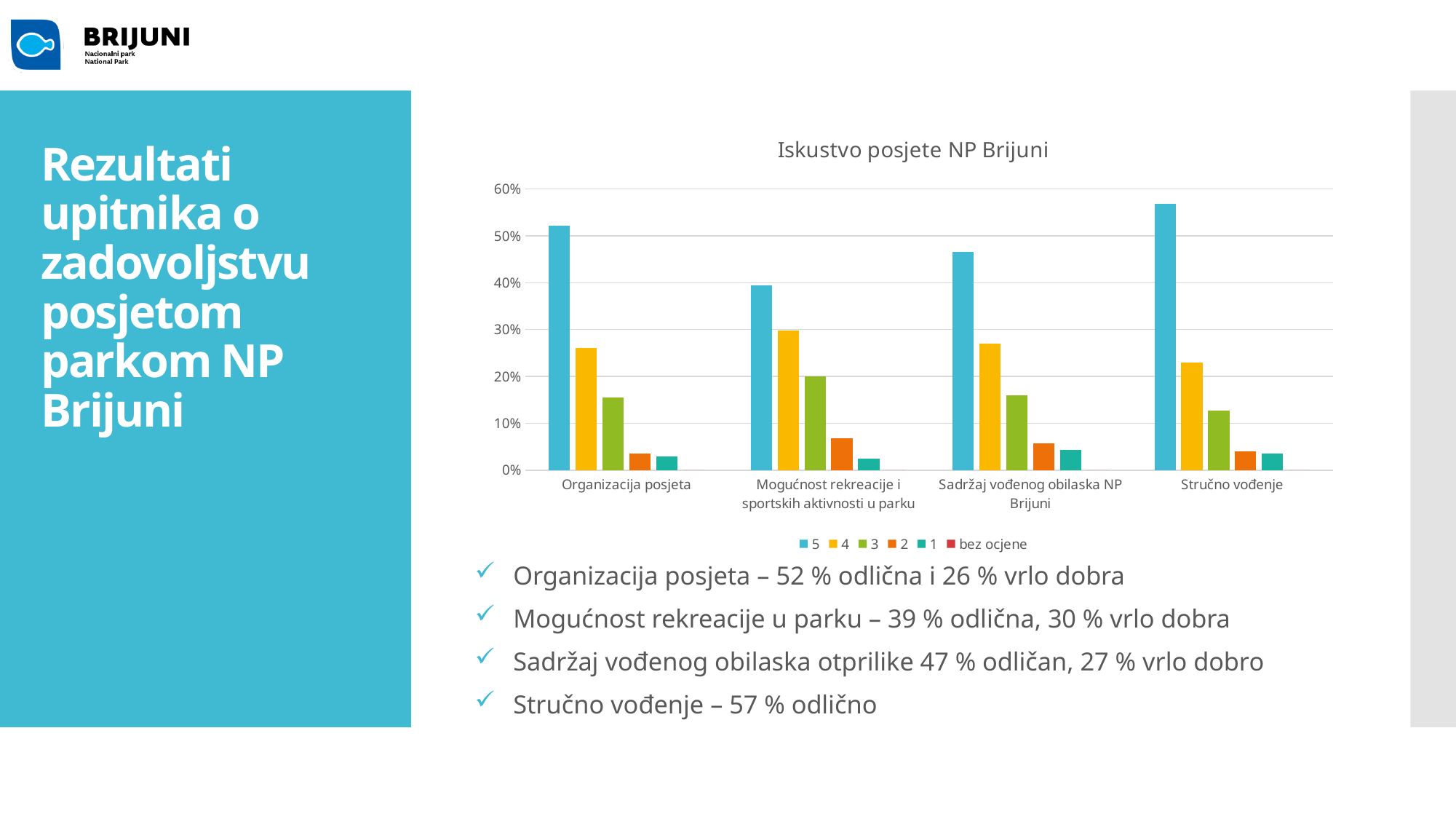
Which category has the lowest bar for series 5? Mogućnost rekreacije i sportskih aktivnosti u parku What is the title of the chart? Iskustvo posjete NP Brijuni Which category has the highest bar for series 4? Mogućnost rekreacije i sportskih aktivnosti u parku Is the value for series 3 in Stručno vođenje greater or less than 20%? less What type of chart is shown on the slide? bar chart Is the value for series 5 in Stručno vođenje greater or less than 50%? greater Which is larger: the series 5 bar for Organizacija posjeta or the series 5 bar for Sadržaj vođenog obilaska NP Brijuni? Organizacija posjeta How many series does the chart legend list? 6 How many categories are shown on the x axis of the chart? 4 Which category has the highest bar for series 5? Stručno vođenje Which category has the highest bar for series 3? Mogućnost rekreacije i sportskih aktivnosti u parku Is the value for series 4 in Organizacija posjeta greater or less than 30%? less